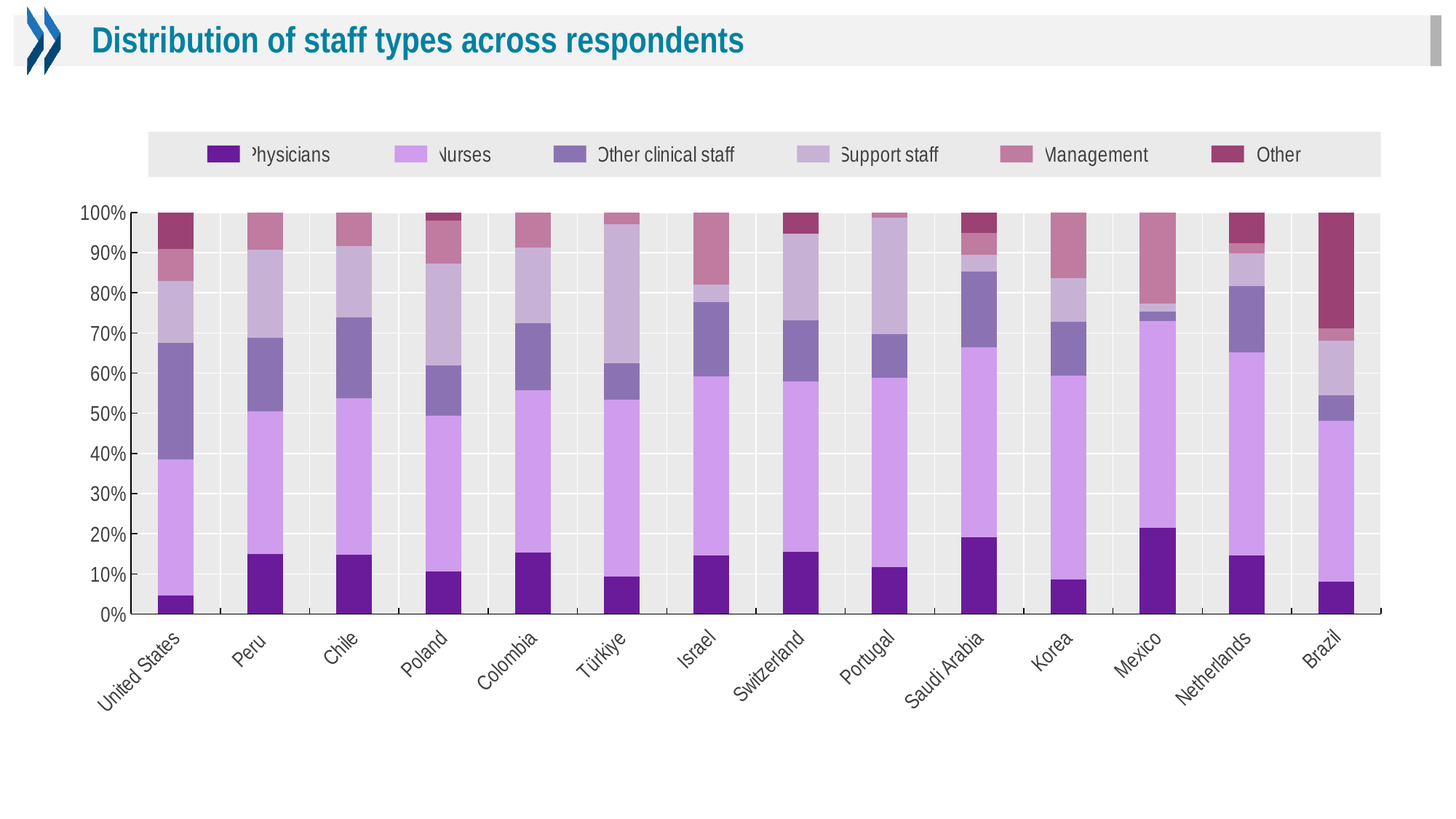
Which country has a larger Other share, Brazil or Peru? Brazil What is the total of each stacked bar in the chart? 100% Which country has the largest Physicians share? Mexico Is the Physicians share for Saudi Arabia greater or less than 10%? greater Which country has a larger Physicians share, Mexico or the United States? Mexico What is the title of the chart? Distribution of staff types across respondents Which country has the smallest Physicians share? United States Is the Physicians share for the United States greater or less than 10%? less Which staff type is listed last in the legend? Other How many countries are shown on the x axis of the chart? 14 What kind of chart is shown on the slide? Stacked bar chart How many series does the legend list? 6